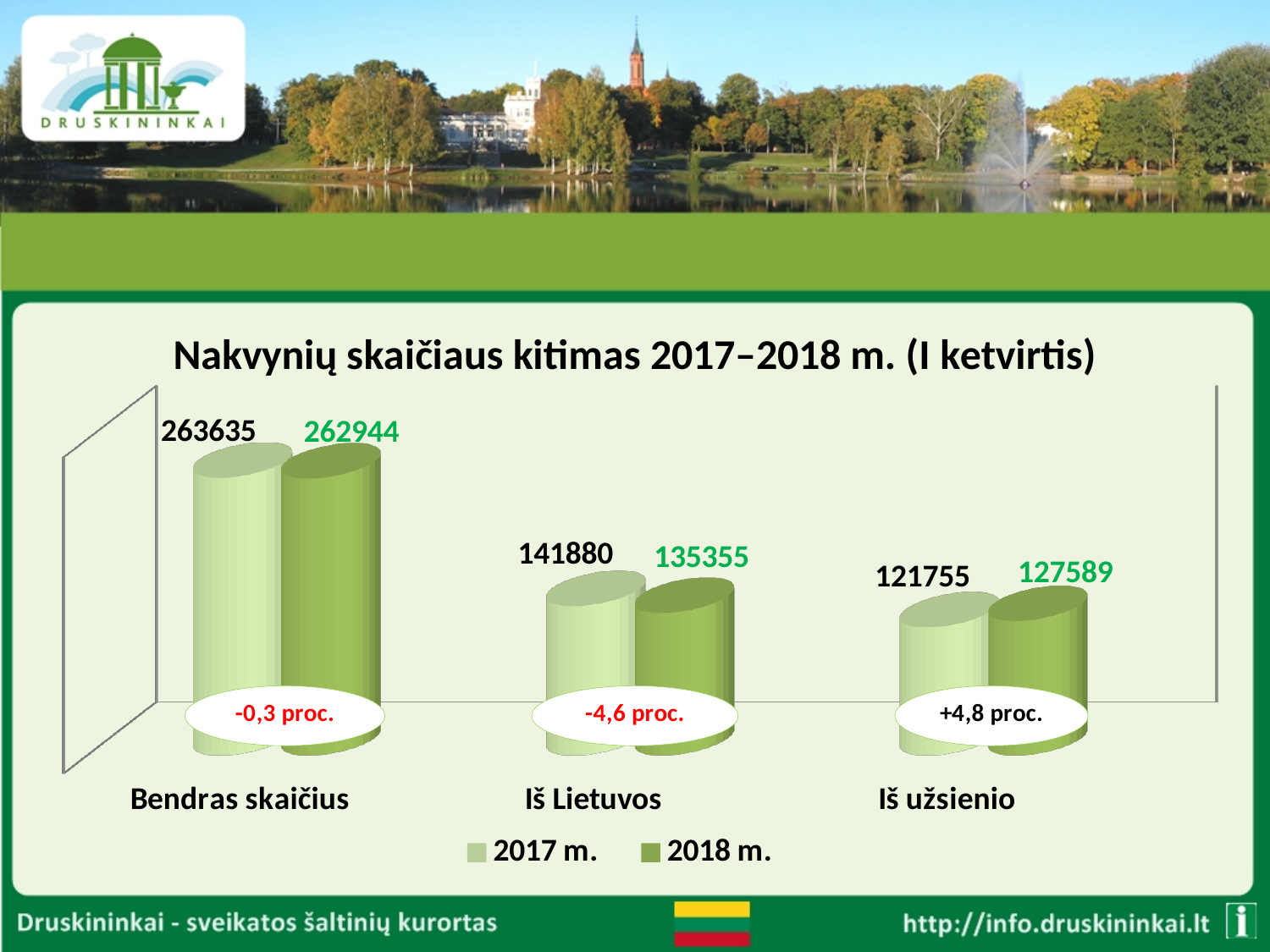
What is the value for 2018 m. in the Iš Lietuvos category? 135355 How many categories are shown on the x axis? 3 Which category has the lowest value for 2017 m.? Iš užsienio What is the value for 2017 m. in the Iš užsienio category? 121755 How many series does the legend list? 2 Which category has the highest value for 2018 m.? Bendras skaičius What kind of chart is shown on the slide? Bar chart Which is larger for Iš užsienio: the 2017 m. value or the 2018 m. value? 2018 m. What is the difference between the 2017 m. and 2018 m. values for Iš Lietuvos? 6525 What is the value for 2017 m. in the Bendras skaičius category? 263635 What is the value for 2018 m. in the Iš užsienio category? 127589 What percentage change is shown in the label for the Iš Lietuvos category? -4,6 proc.